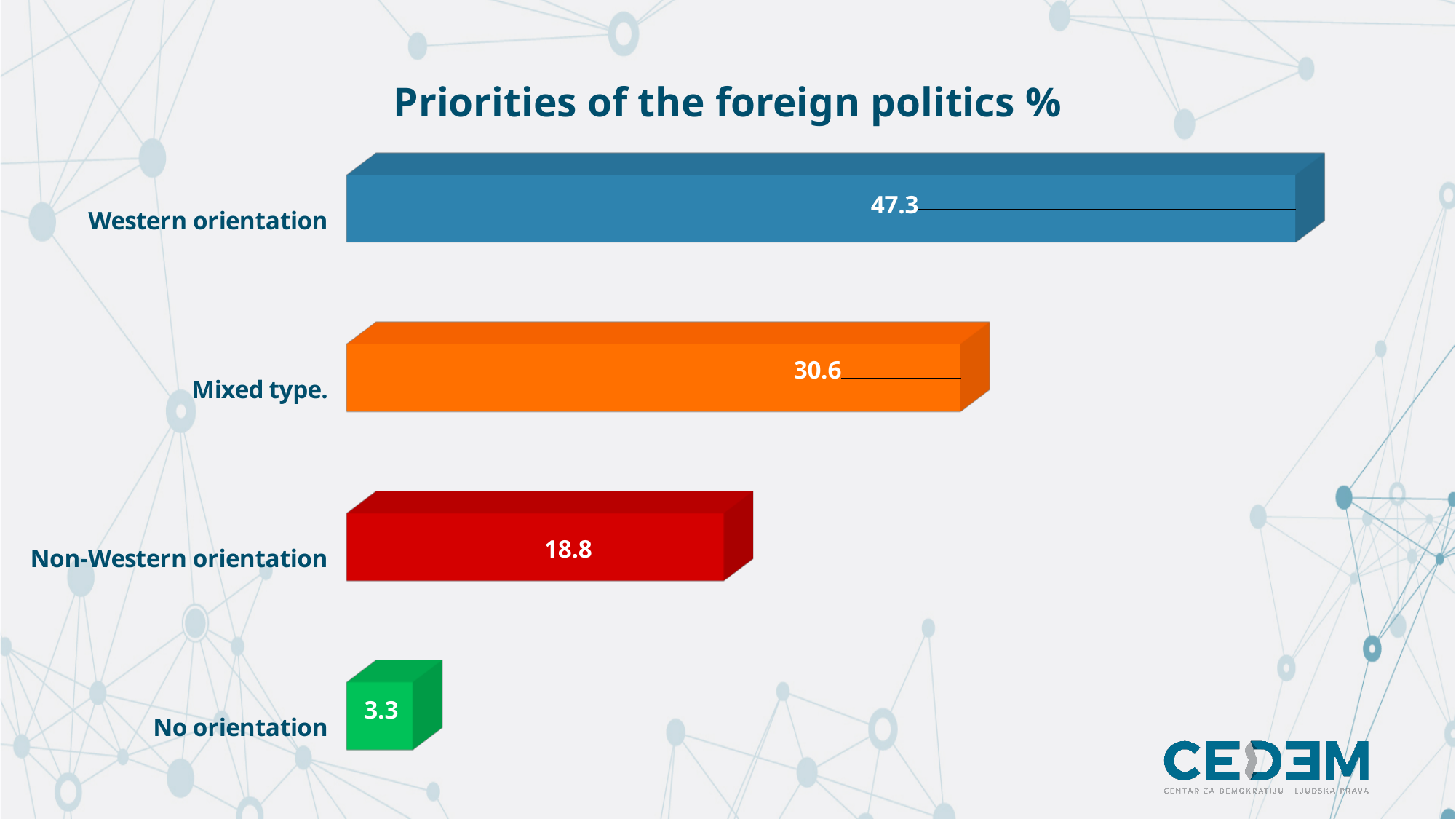
What is the value for Mixed type.? 30.6 Which category has the lowest value? No orientation What is the difference between the values for Non-Western orientation and No orientation? 15.5 What is the value for Western orientation? 47.3 What is the difference between the values for Western orientation and Mixed type.? 16.7 How many categories are shown in the chart? 4 What is the value for No orientation? 3.3 What is the title of the chart? Priorities of the foreign politics % What is the value for Non-Western orientation? 18.8 Which is larger, the value for Mixed type. or the value for Non-Western orientation? Mixed type. What kind of chart is shown on the slide? bar chart Which category has the highest value? Western orientation